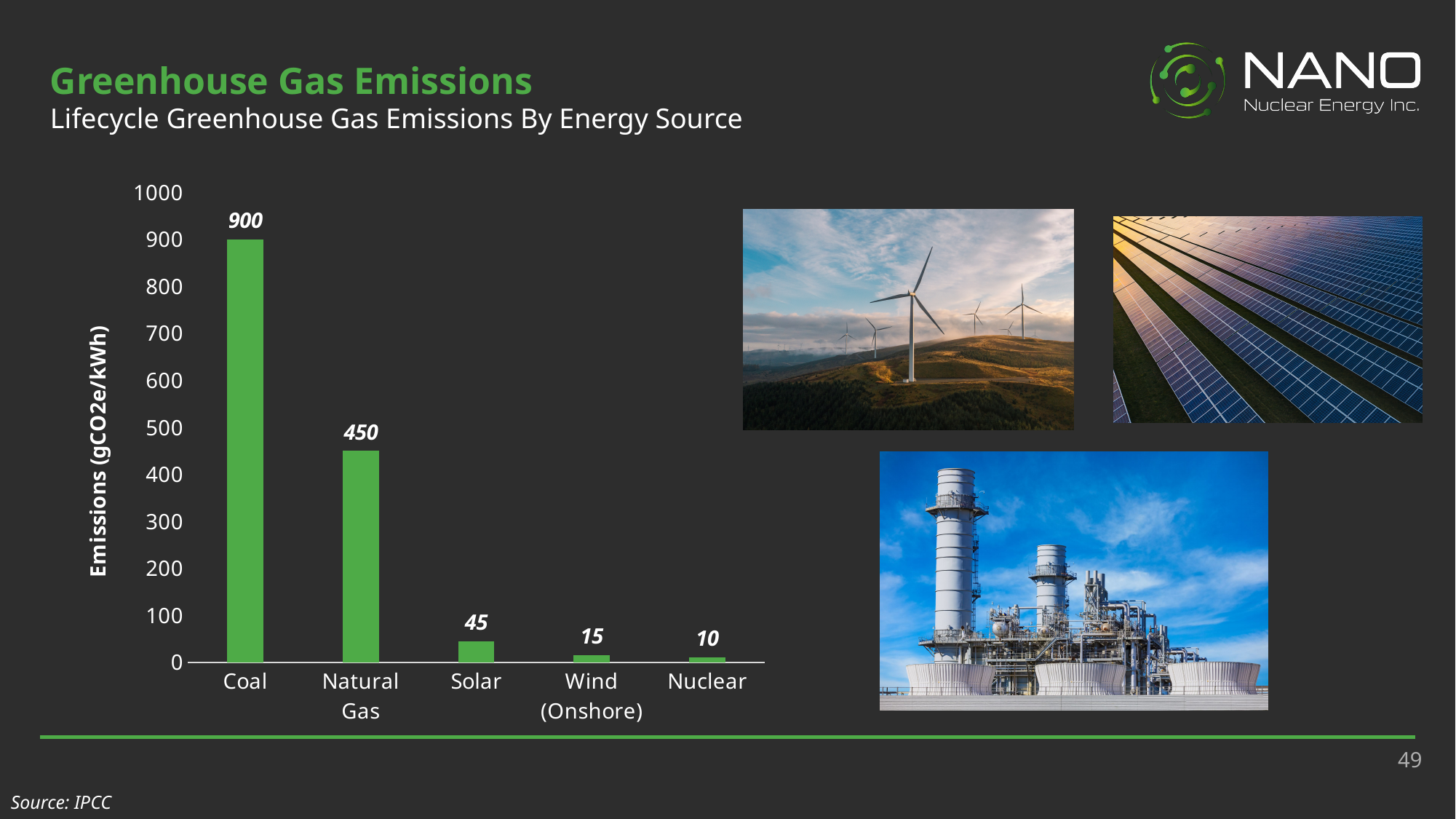
What is the emissions value for Natural Gas? 450 What is the emissions value for Wind (Onshore)? 15 What is the emissions value for Solar? 45 What is the difference in emissions between Coal and Natural Gas? 450 What is the emissions value for Nuclear? 10 What kind of chart is shown on the slide? Bar chart Which energy source has the lowest emissions? Nuclear What is the emissions value for Coal? 900 How many energy sources are shown in the chart? 5 Which energy source has the highest emissions? Coal What is the label of the vertical axis? Emissions (gCO2e/kWh) Which has higher emissions, Solar or Wind (Onshore)? Solar